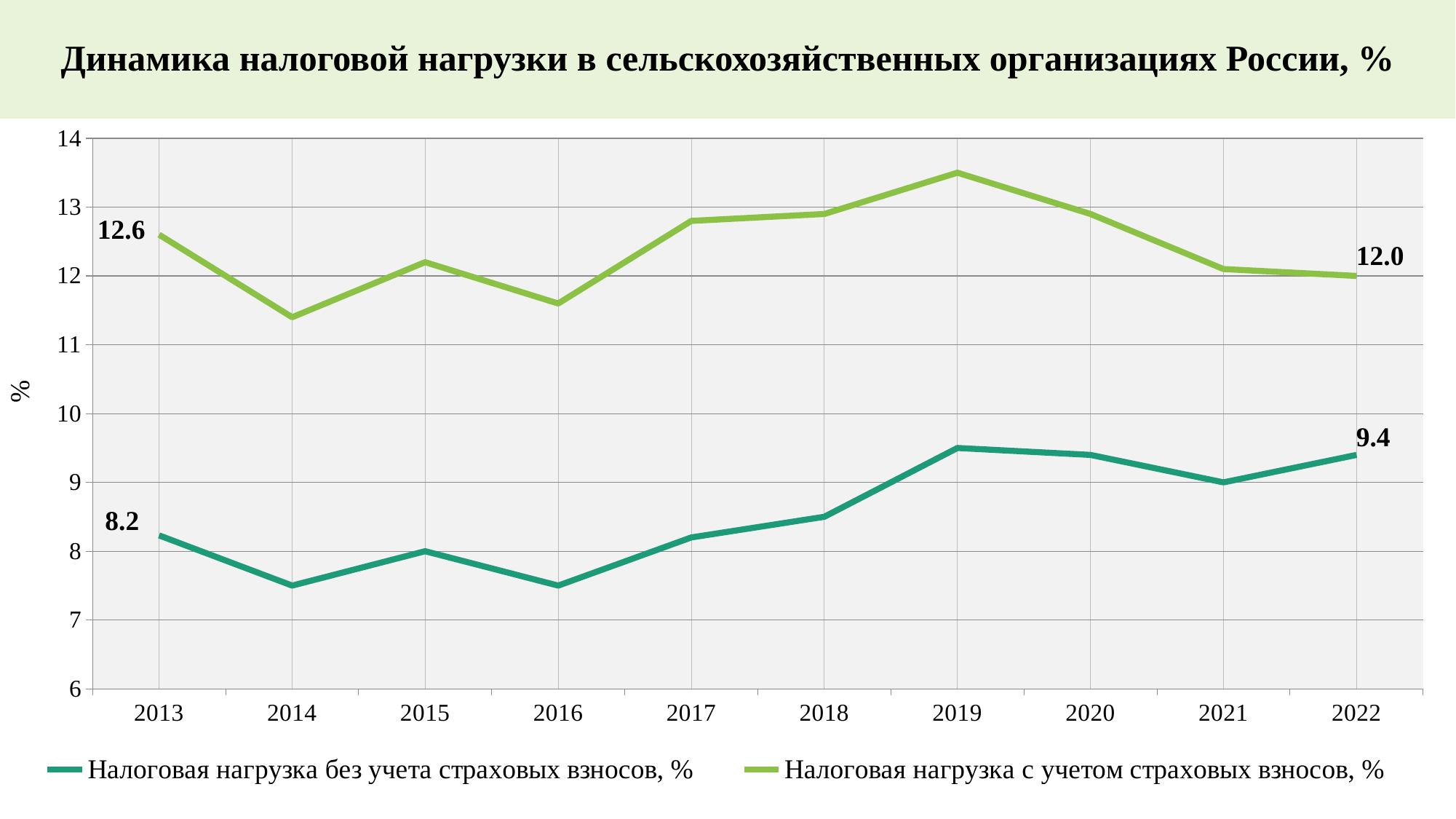
What is the value of 'Налоговая нагрузка с учетом страховых взносов, %' in 2013? 12.6 How many years are shown on the x axis? 10 What is the value of 'Налоговая нагрузка с учетом страховых взносов, %' in 2022? 12.0 By how much did 'Налоговая нагрузка без учета страховых взносов, %' change from 2013 to 2022? 1.2 Is the value of 'Налоговая нагрузка без учета страховых взносов, %' in 2014 greater or less than 8? less Does 'Налоговая нагрузка с учетом страховых взносов, %' rise or fall from 2019 to 2022? Fall How many series does the legend list? 2 Is the value of 'Налоговая нагрузка с учетом страховых взносов, %' in 2019 greater or less than 13? greater In which year does 'Налоговая нагрузка с учетом страховых взносов, %' reach its highest value? 2019 What type of chart is shown on the slide? Line chart What is the value of 'Налоговая нагрузка без учета страховых взносов, %' in 2013? 8.2 What is the difference between the two series' values in 2013? 4.4